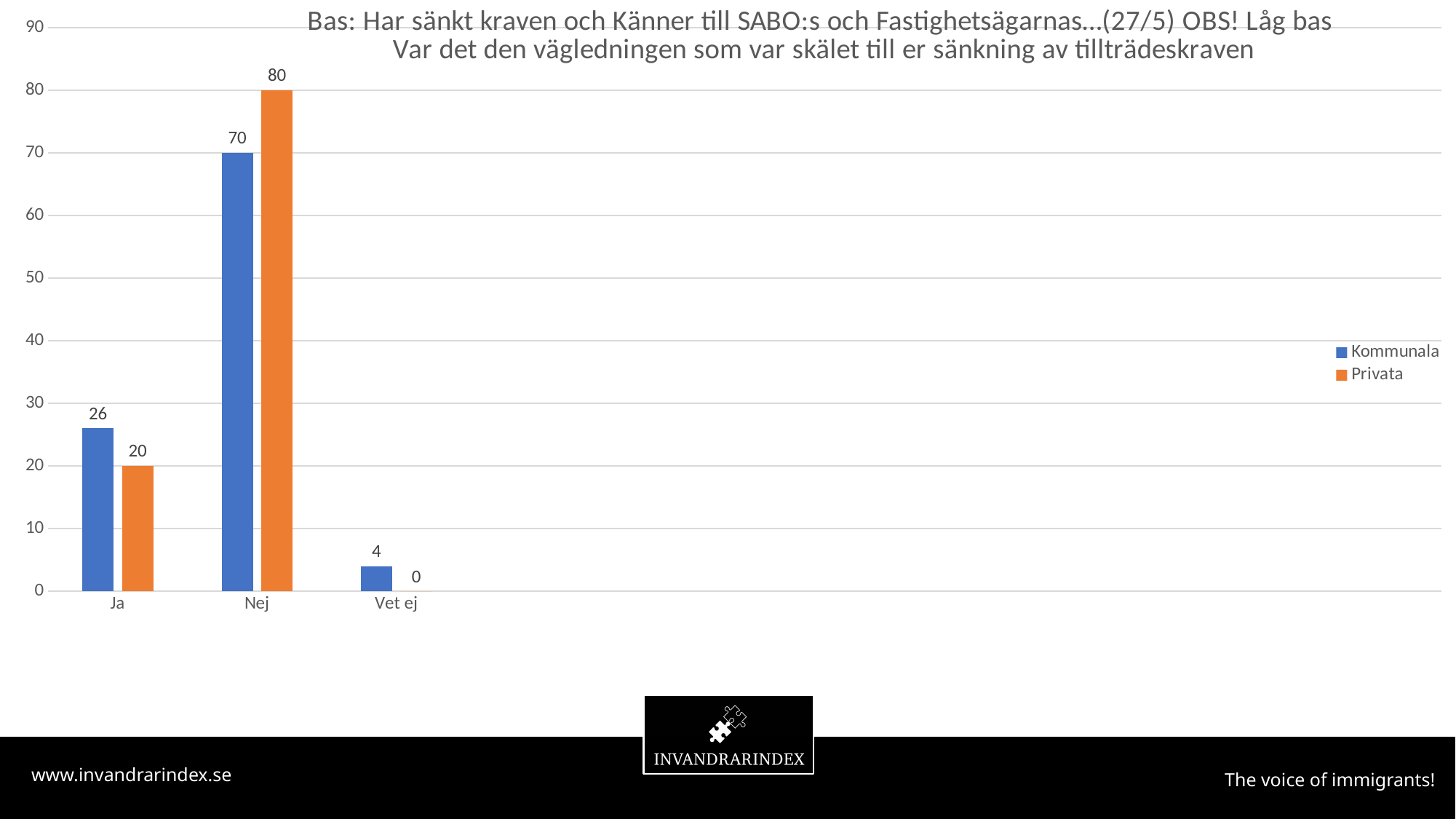
What is the value for Privata in the Nej category? 80 Which category has the lowest value for the Privata series? Vet ej What is the value for Kommunala in the Vet ej category? 4 How many categories are shown on the x axis? 3 What is the difference between the Kommunala and Privata values in the Ja category? 6 Which category has the highest value for the Kommunala series? Nej What is the value for Kommunala in the Ja category? 26 What kind of chart is shown on the slide? Bar chart In the Ja category, which series has the larger value, Kommunala or Privata? Kommunala How many series does the legend list? 2 What is the difference between the Privata and Kommunala values in the Nej category? 10 What is the value for Privata in the Vet ej category? 0